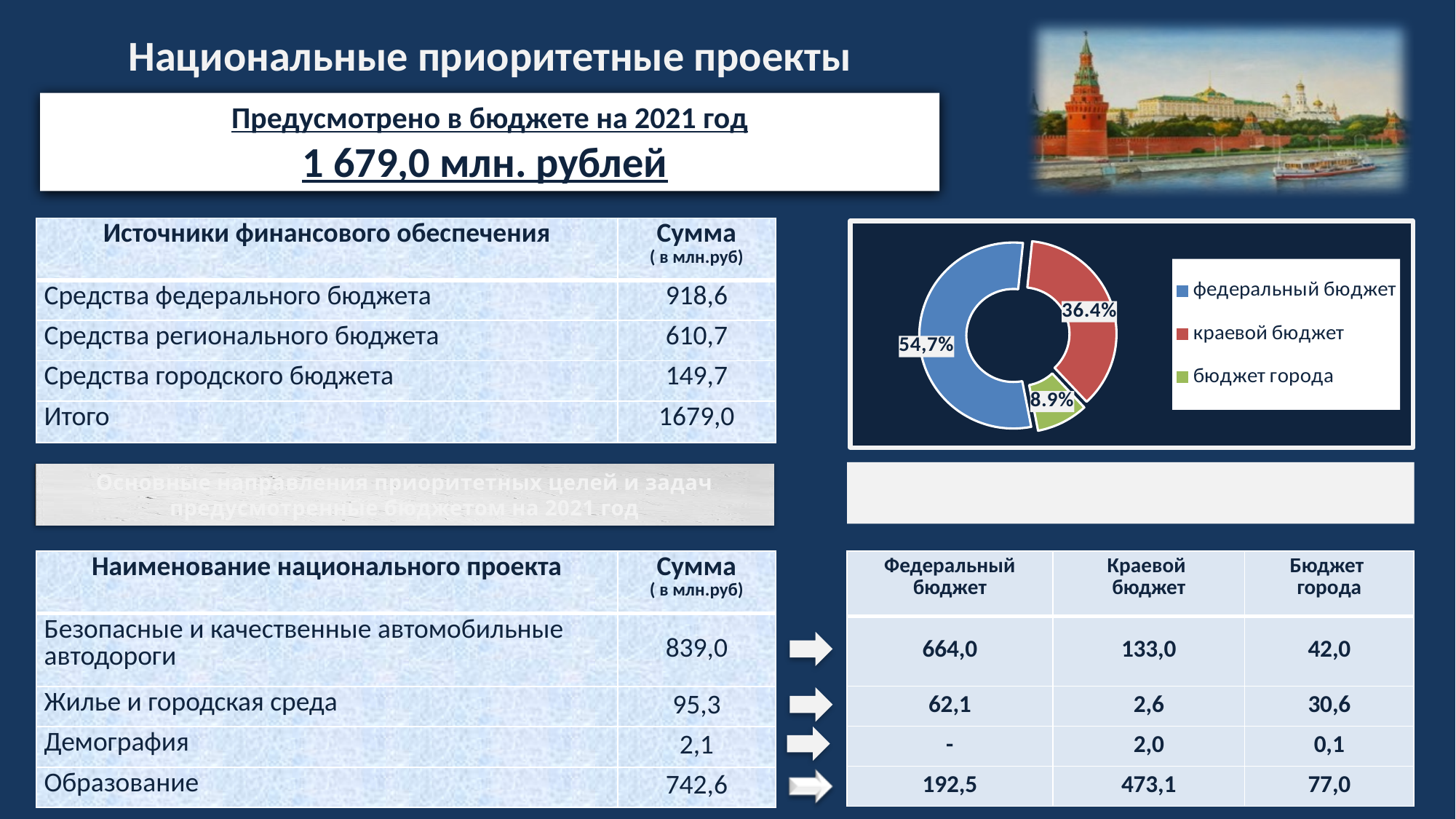
Is the share of федеральный бюджет in the pie chart greater or less than 50%? greater What share of the pie chart does the федеральный бюджет slice represent? 54,7% What percentage is shown for бюджет города in the pie chart? 8.9% What percentage is shown for краевой бюджет in the pie chart? 36.4% In the pie chart, which is larger: краевой бюджет or бюджет города? краевой бюджет What is the difference in percentage points between the краевой бюджет slice and the бюджет города slice? 27.5% Which category has the largest slice in the pie chart? федеральный бюджет What colour represents краевой бюджет in the pie chart? Red How many entries does the legend of the pie chart list? 3 How many slices does the pie chart have? 3 What type of chart is shown on the slide? Pie chart (doughnut) Which category has the smallest slice in the pie chart? бюджет города